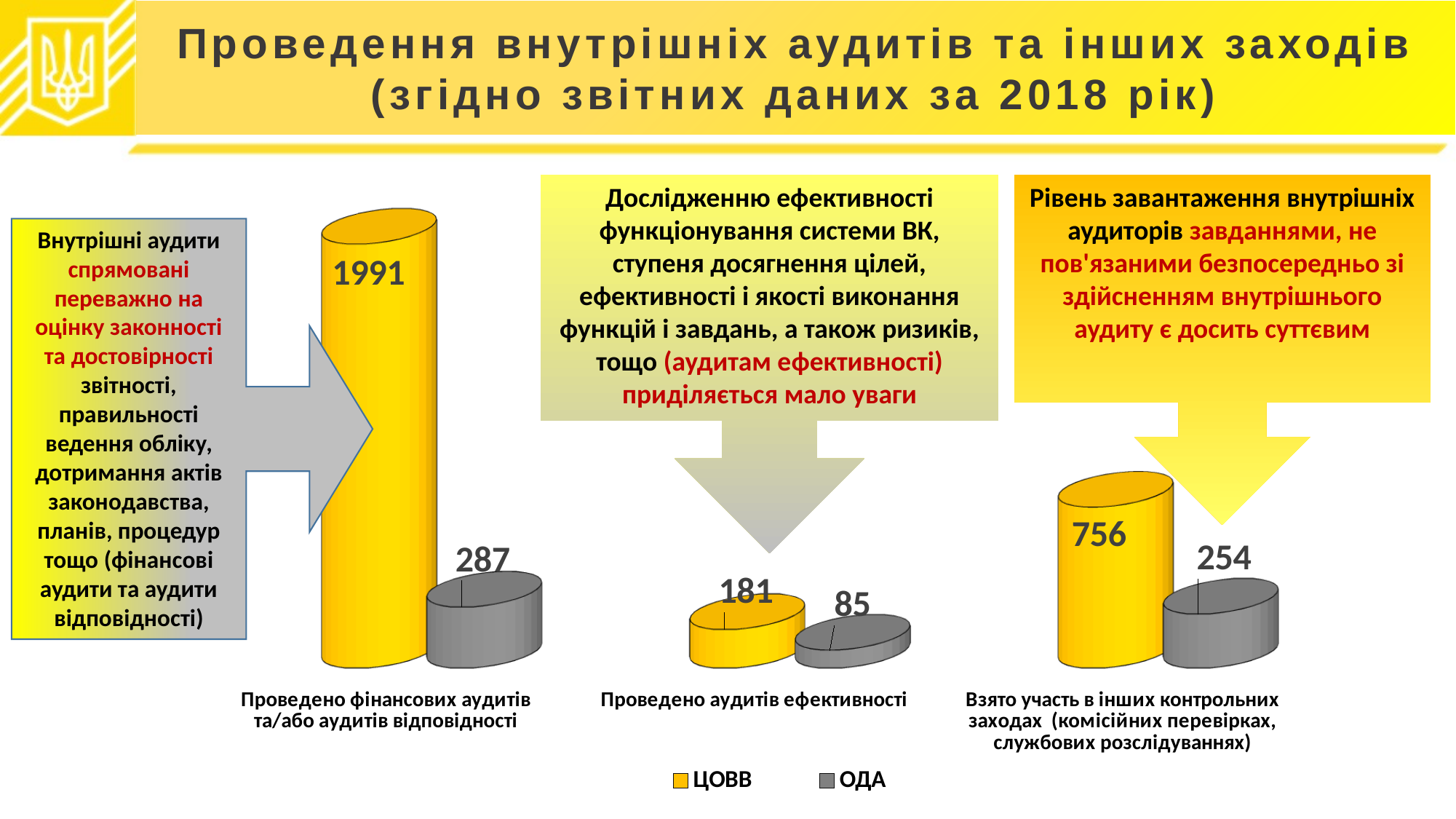
Which is larger: the ОДА value for "Проведено фінансових аудитів та/або аудитів відповідності" or the ОДА value for "Взято участь в інших контрольних заходах"? Проведено фінансових аудитів та/або аудитів відповідності What is the value for ОДА in the category "Проведено фінансових аудитів та/або аудитів відповідності"? 287 What is the value for ОДА in the category "Проведено аудитів ефективності"? 85 Which category has the highest value for ЦОВВ? Проведено фінансових аудитів та/або аудитів відповідності What is the value for ЦОВВ in the category "Проведено фінансових аудитів та/або аудитів відповідності"? 1991 What is the difference between the ЦОВВ and ОДА values in the category "Проведено аудитів ефективності"? 96 What is the value for ЦОВВ in the category "Взято участь в інших контрольних заходах"? 756 What colour represents the ОДА series in the chart? Grey What is the difference between the ЦОВВ and ОДА values in the category "Взято участь в інших контрольних заходах"? 502 How many series does the legend list? 2 How many categories are shown in the chart? 3 Which category has the lowest value for ОДА? Проведено аудитів ефективності